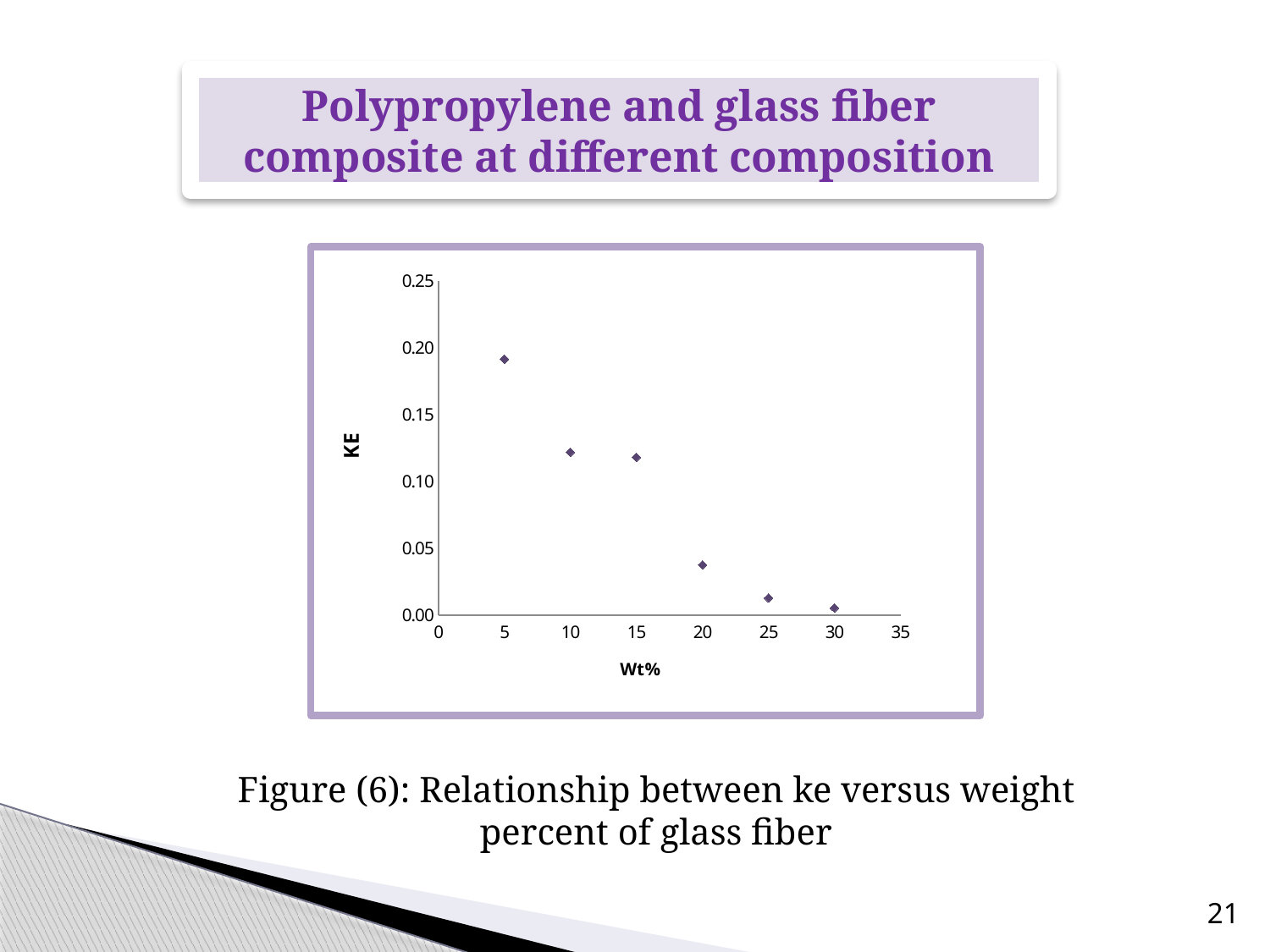
Which has the larger KE value: 20 Wt% or 25 Wt%? 20 Wt% At which Wt% value is KE highest? 5 Is the KE value at 5 Wt% greater or less than 0.15? greater Is the KE value at 20 Wt% greater or less than 0.05? less What kind of chart is shown on the slide? scatter chart What is the label on the y axis of the chart? KE Is the KE value at 10 Wt% greater or less than 0.10? greater Which has the larger KE value: 5 Wt% or 10 Wt%? 5 Wt% Do the KE values rise or fall as Wt% increases along the x axis? fall What is the label on the x axis of the chart? Wt% How many data points are plotted on the chart? 6